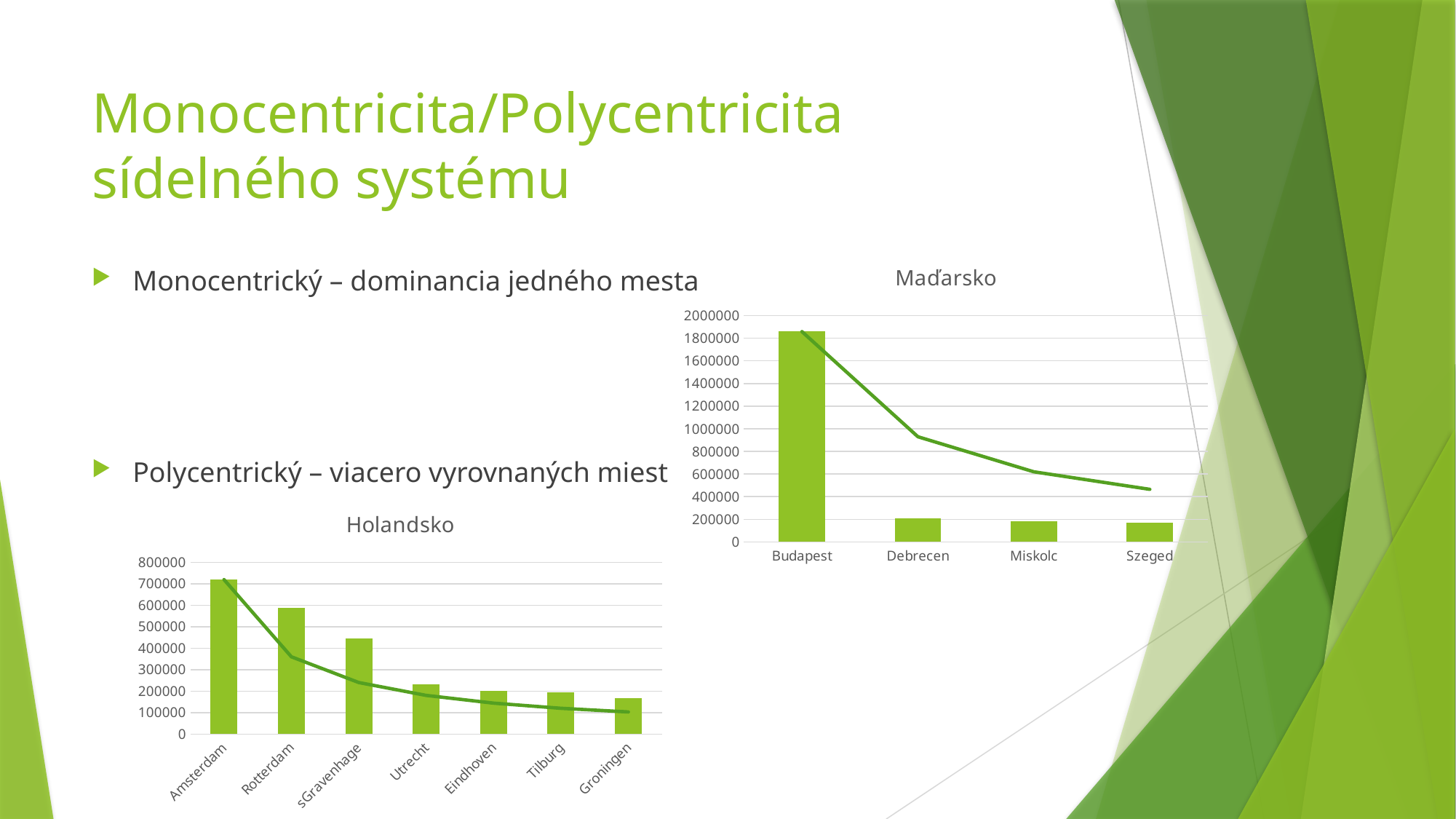
In the Holandsko chart, is the bar for Rotterdam greater or less than 500000? greater In the Holandsko chart, do the bar values rise or fall from Amsterdam to Groningen? fall In the Holandsko chart, which city has the highest bar? Amsterdam What kind of chart is the Holandsko chart? bar chart with a line How many cities are shown on the x axis of the Maďarsko chart? 4 In the Holandsko chart, is the bar for Utrecht greater or less than 300000? less In the Holandsko chart, which city has the lowest bar? Groningen How many cities are shown on the x axis of the Holandsko chart? 7 In the Maďarsko chart, which city has the highest bar? Budapest In the Maďarsko chart, is the bar for Budapest larger or smaller than the bar for Debrecen? larger In the Maďarsko chart, is the bar for Debrecen greater or less than 400000? less